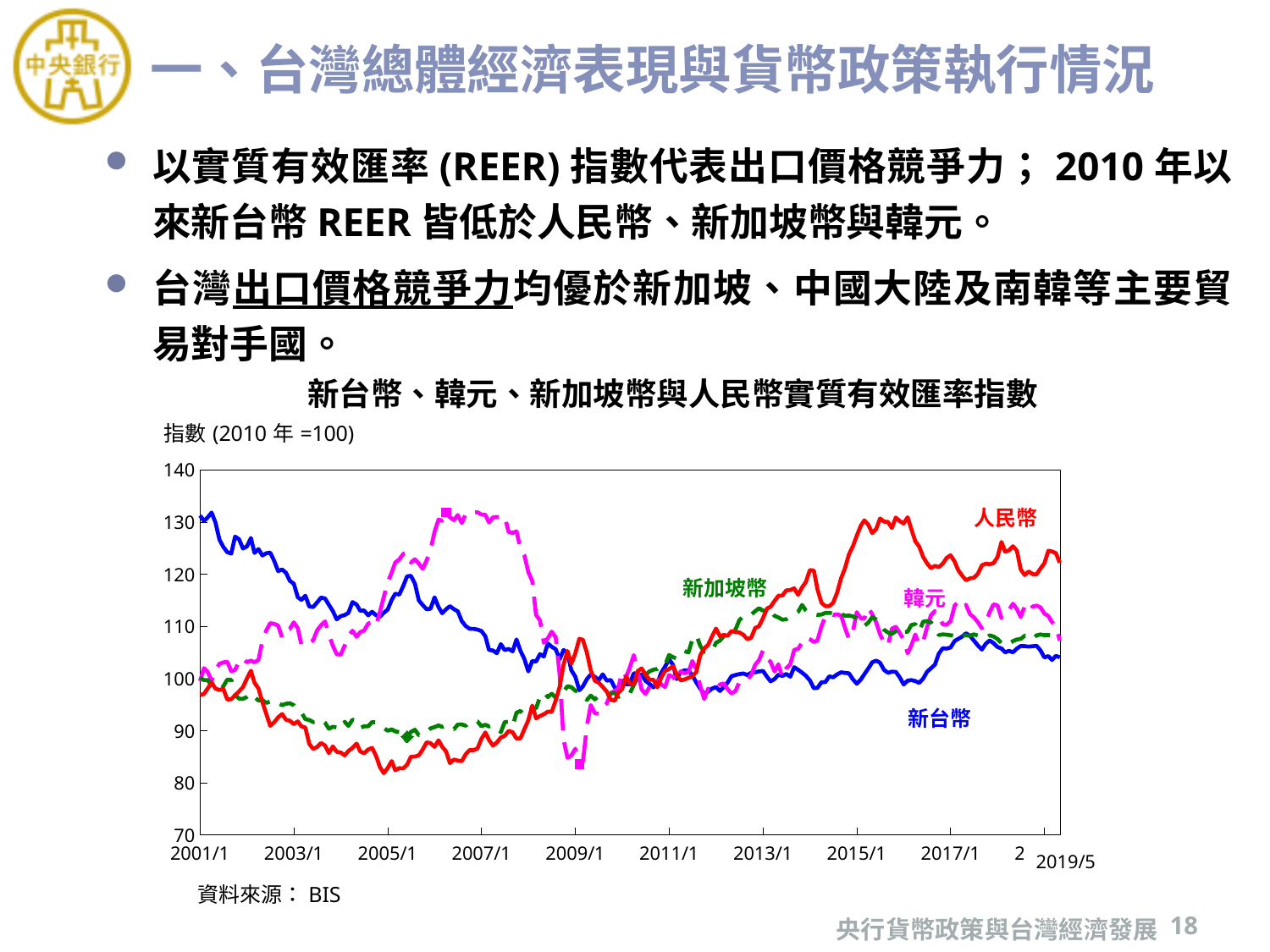
How many currency series are plotted in the chart? 4 At 2005/1, which is higher: 新台幣 or 人民幣? 新台幣 Is the value for 人民幣 at 2019/5 greater or less than 110? greater What kind of chart is shown on the slide? line chart Is the value for 人民幣 at 2005/1 greater or less than 90? less Does the 人民幣 index rise or fall between 2009/1 and 2015/1? rise Which currency has the highest real effective exchange rate index at the end of the chart (2019/5)? 人民幣 Which currency has the lowest real effective exchange rate index at the end of the chart (2019/5)? 新台幣 Is the value for 韓元 at 2007/1 greater or less than 120? greater What is the data source cited below the chart? BIS Does the 新台幣 index rise or fall between 2001/1 and 2009/1? fall